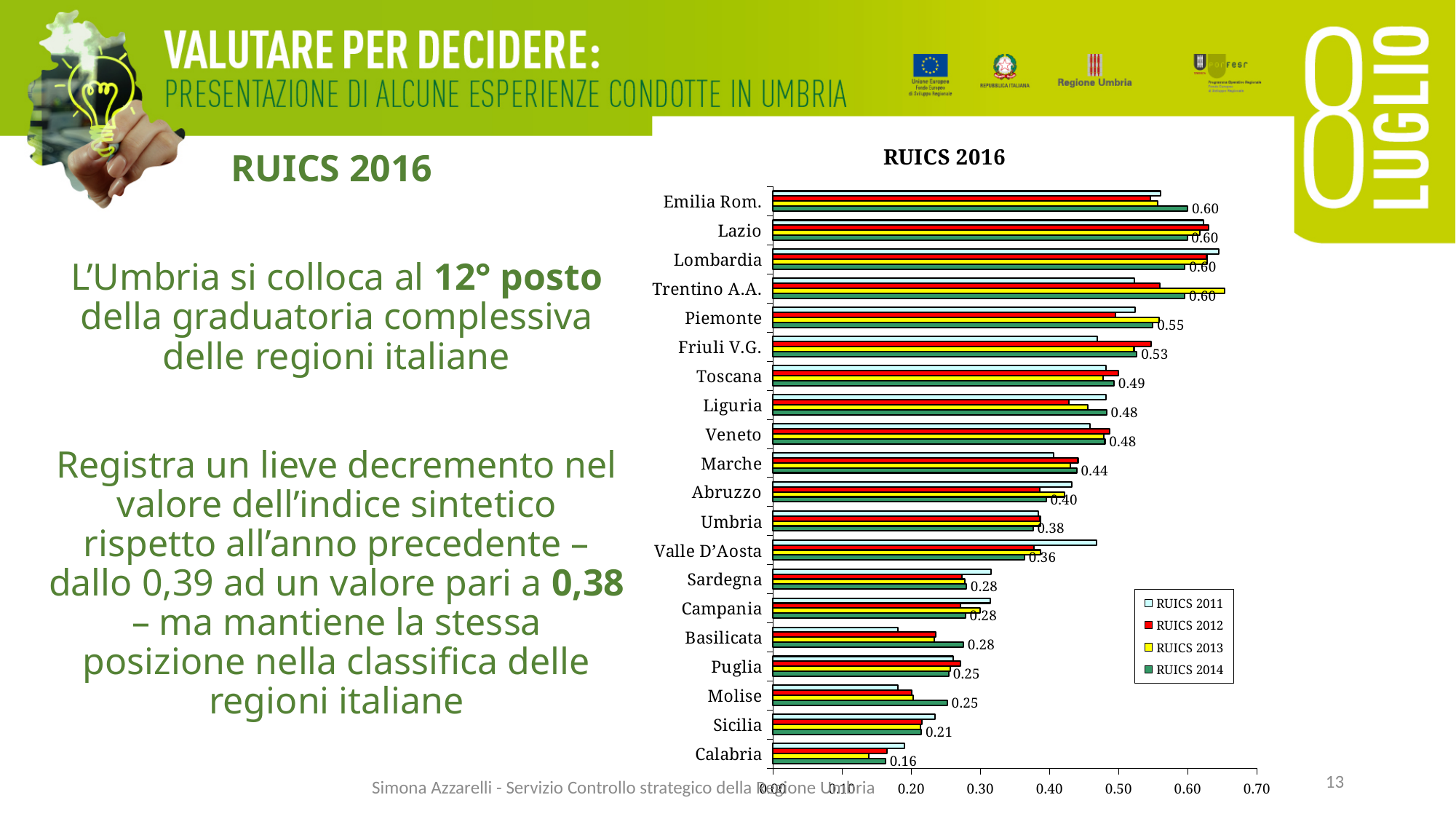
What is the RUICS 2014 value for Piemonte? 0.55 Which region has the lowest RUICS 2014 value? Calabria What is the RUICS 2014 value for Umbria? 0.38 What type of chart is shown on the slide? Bar chart How many series does the legend list? 4 Is the RUICS 2011 value for Lombardia greater or less than 0.60? greater What is the RUICS 2014 value for Calabria? 0.16 Which region has the larger RUICS 2014 value, Piemonte or Toscana? Piemonte Is the RUICS 2011 value for Valle D'Aosta greater or less than 0.50? less Which series is shown in red in the legend? RUICS 2012 How many regions are shown on the chart? 20 What is the difference between the RUICS 2014 values of Umbria and Calabria? 0.22